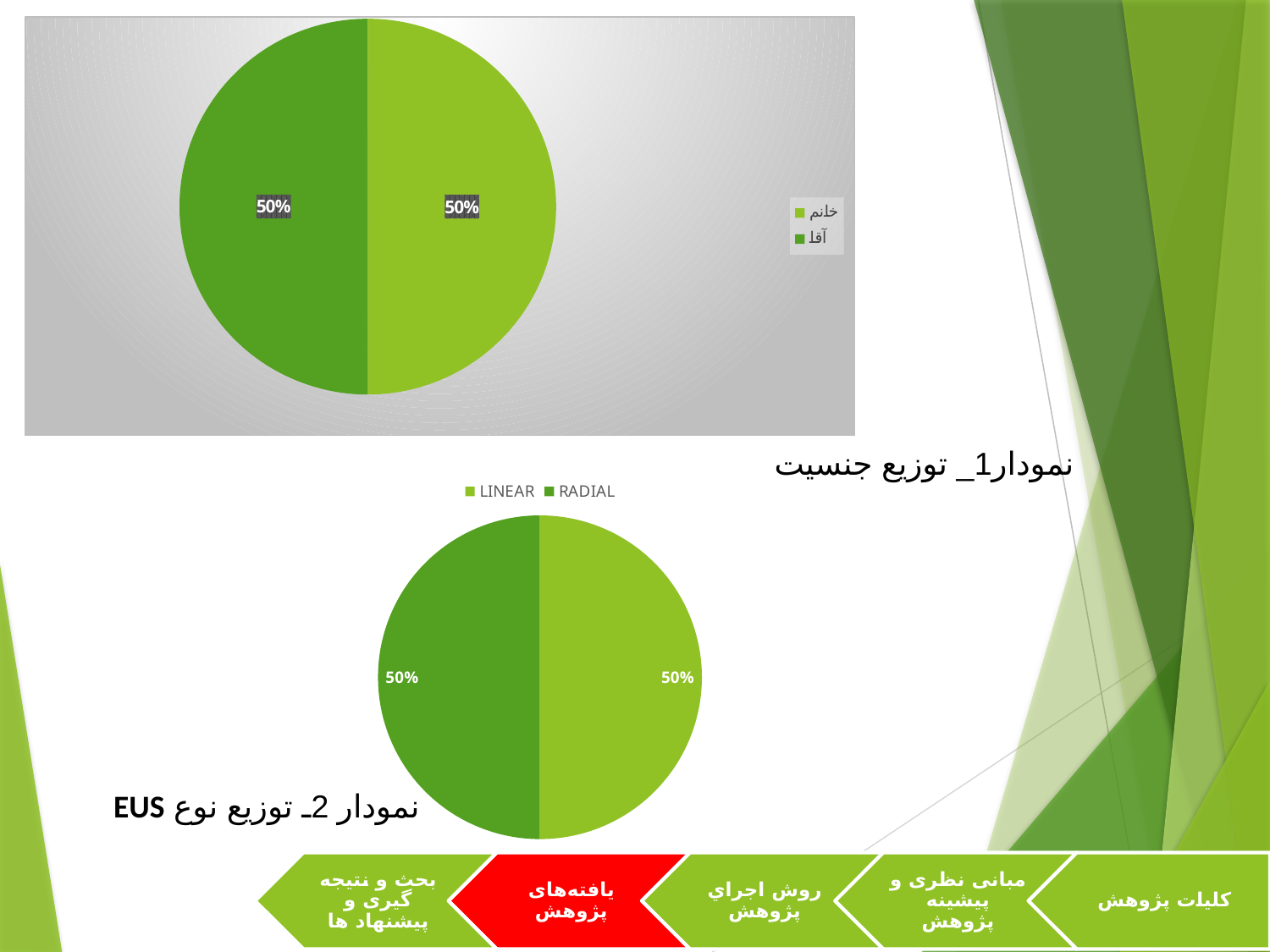
In the top chart (gender distribution), what share of the pie is labelled آقا? 50% What are the two legend entries of the top chart? خانم and آقا How many slices does the bottom pie chart have? 2 In the top chart (gender distribution), what share of the pie is labelled خانم? 50% In the bottom chart (EUS type distribution), what share of the pie is LINEAR? 50% What kind of chart is the top chart on the slide? pie chart What are the two legend entries of the bottom chart? LINEAR and RADIAL How many slices does the top pie chart have? 2 How many entries does the legend of the bottom chart list? 2 What kind of chart is the bottom chart on the slide? pie chart In the bottom chart, is the LINEAR slice larger than, smaller than, or equal to the RADIAL slice? equal